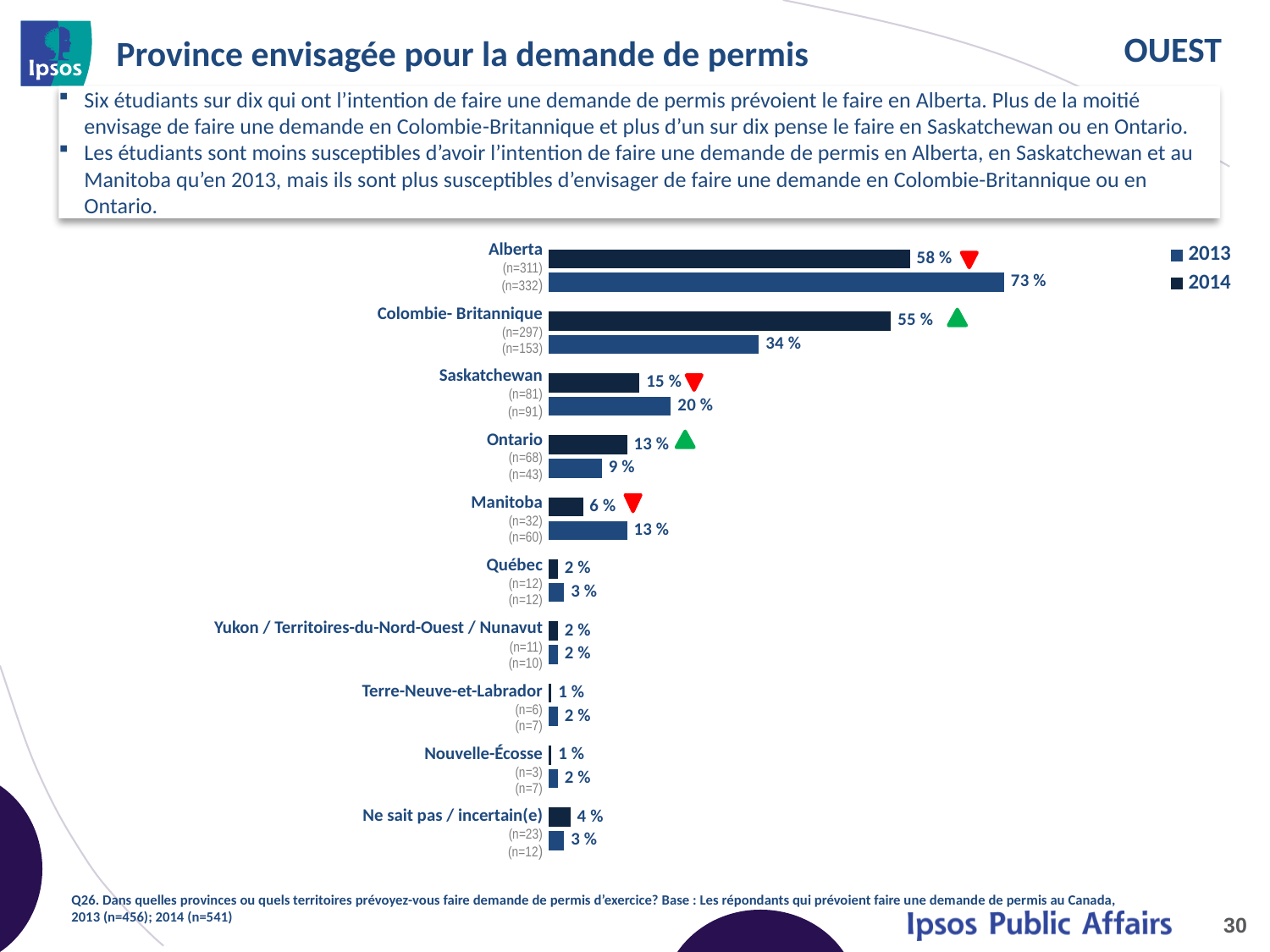
What is the value of the upper bar for 'Ne sait pas / incertain(e)'? 4 % Which category has the highest value on the chart? Alberta What is the value of the lower bar for Alberta? 73 % What is the difference between the upper bar (55 %) and the lower bar (34 %) for Colombie-Britannique? 21 % What is the difference between the lower bar (20 %) and the upper bar (15 %) for Saskatchewan? 5 % Which two entries appear in the chart legend? 2013 and 2014 What is the value of the upper bar for Alberta? 58 % What kind of chart is shown on the slide? Bar chart How many categories (provinces/territories and 'Ne sait pas') are shown on the chart? 10 Which is larger: the upper bar for Ontario or the upper bar for Manitoba? Ontario How many series does the chart legend list? 2 What is the value of the lower bar for Colombie-Britannique? 34 %